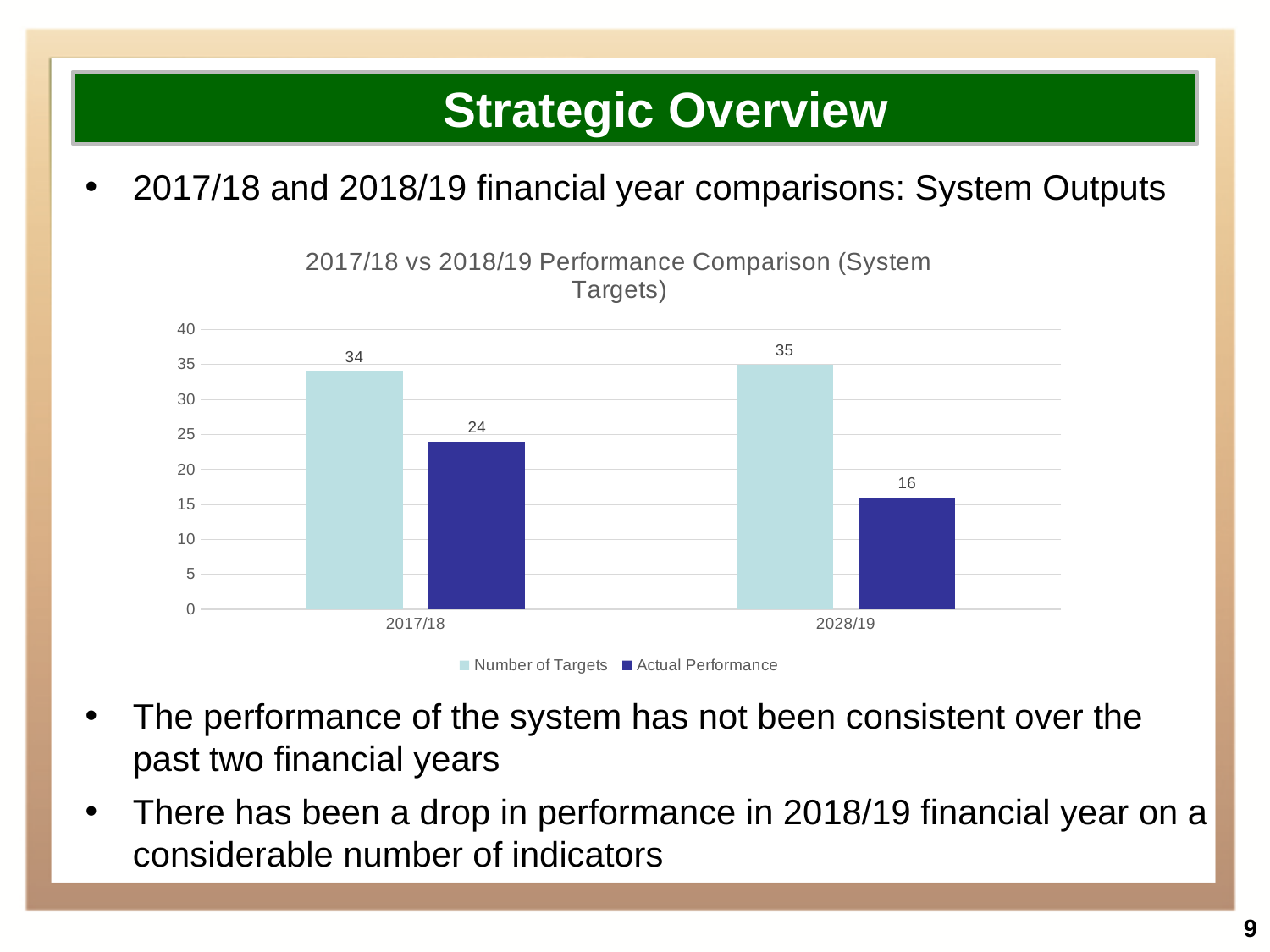
What is the title of the chart? 2017/18 vs 2018/19 Performance Comparison (System Targets) What kind of chart is shown on the slide? Bar chart What is the Number of Targets for 2028/19? 35 Which category has the lowest Actual Performance? 2028/19 What is the Actual Performance for 2028/19? 16 What is the difference between Number of Targets and Actual Performance for 2017/18? 10 What is the Actual Performance for 2017/18? 24 Which is larger, the Actual Performance for 2017/18 or for 2028/19? 2017/18 What is the difference between Number of Targets and Actual Performance for 2028/19? 19 Does Actual Performance rise or fall from 2017/18 to 2028/19? Fall What is the Number of Targets for 2017/18? 34 How many series does the legend list? 2